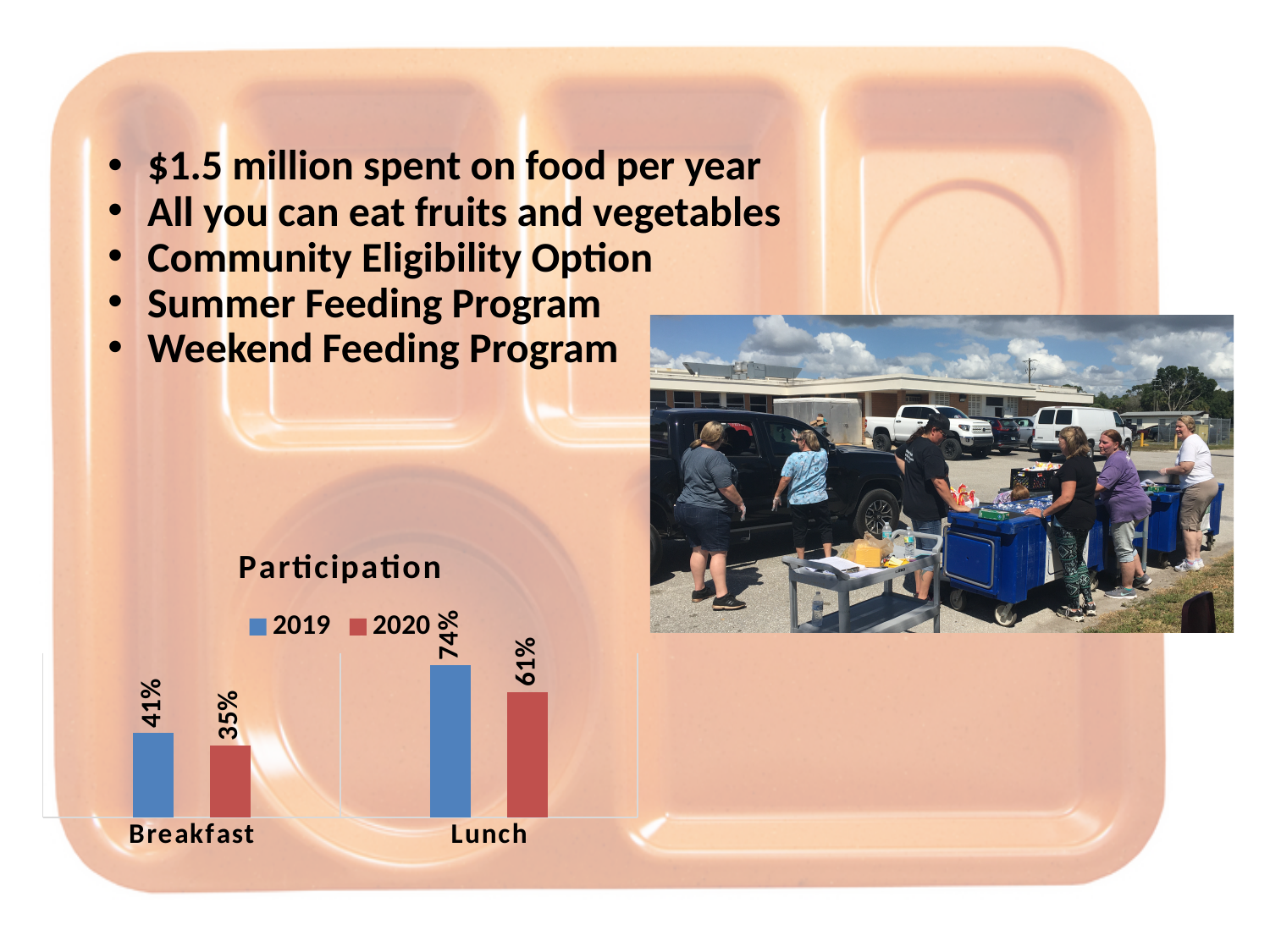
What is the difference between the 2019 and 2020 values for Breakfast? 6% What is the 2020 participation value for Breakfast? 35% Which category has the highest 2019 participation value? Lunch How many series does the chart legend list? 2 Which is larger, the 2019 value for Breakfast or the 2020 value for Lunch? 2020 value for Lunch How many categories are shown on the x axis of the chart? 2 What is the 2019 participation value for Lunch? 74% What is the 2019 participation value for Breakfast? 41% What is the 2020 participation value for Lunch? 61% What type of chart is shown on the slide? Bar chart Which category has the lowest 2020 participation value? Breakfast What is the difference between the 2019 and 2020 values for Lunch? 13%